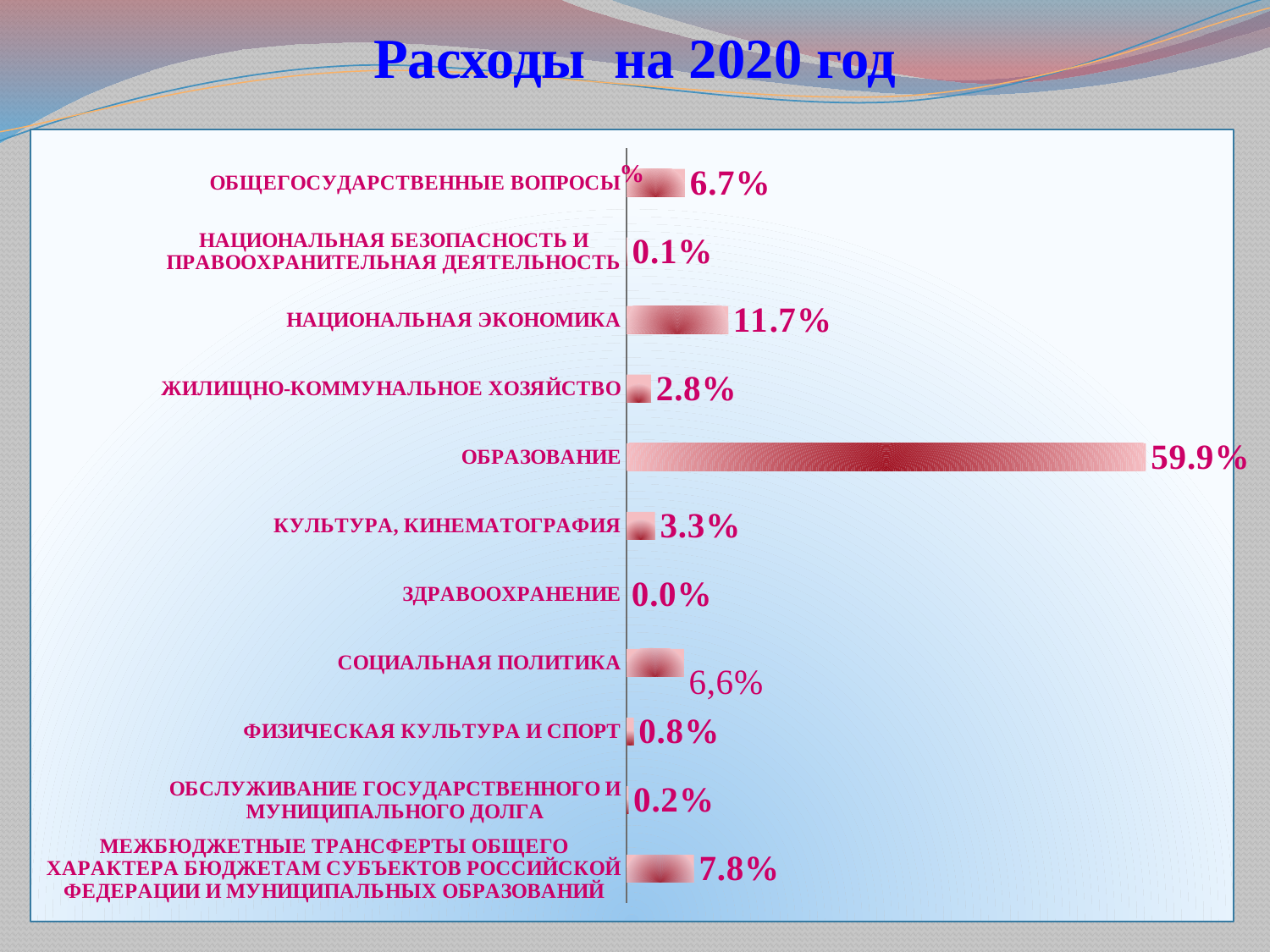
Which category has the highest value? ОБРАЗОВАНИЕ Which is larger: the value for ОБЩЕГОСУДАРСТВЕННЫЕ ВОПРОСЫ or the value for МЕЖБЮДЖЕТНЫЕ ТРАНСФЕРТЫ ОБЩЕГО ХАРАКТЕРА БЮДЖЕТАМ СУБЪЕКТОВ РОССИЙСКОЙ ФЕДЕРАЦИИ И МУНИЦИПАЛЬНЫХ ОБРАЗОВАНИЙ? МЕЖБЮДЖЕТНЫЕ ТРАНСФЕРТЫ ОБЩЕГО ХАРАКТЕРА БЮДЖЕТАМ СУБЪЕКТОВ РОССИЙСКОЙ ФЕДЕРАЦИИ И МУНИЦИПАЛЬНЫХ ОБРАЗОВАНИЙ Which category has the lowest value? ЗДРАВООХРАНЕНИЕ What is the value for СОЦИАЛЬНАЯ ПОЛИТИКА? 6,6% What is the value for ЖИЛИЩНО-КОММУНАЛЬНОЕ ХОЗЯЙСТВО? 2.8% What is the value for ОБРАЗОВАНИЕ? 59.9% What type of chart is shown on the slide? Bar chart What is the difference between the values for ОБРАЗОВАНИЕ and НАЦИОНАЛЬНАЯ ЭКОНОМИКА? 48.2% How many categories are shown in the chart? 11 What is the value for ФИЗИЧЕСКАЯ КУЛЬТУРА И СПОРТ? 0.8% What is the value for НАЦИОНАЛЬНАЯ ЭКОНОМИКА? 11.7% What is the title of the chart? Расходы на 2020 год